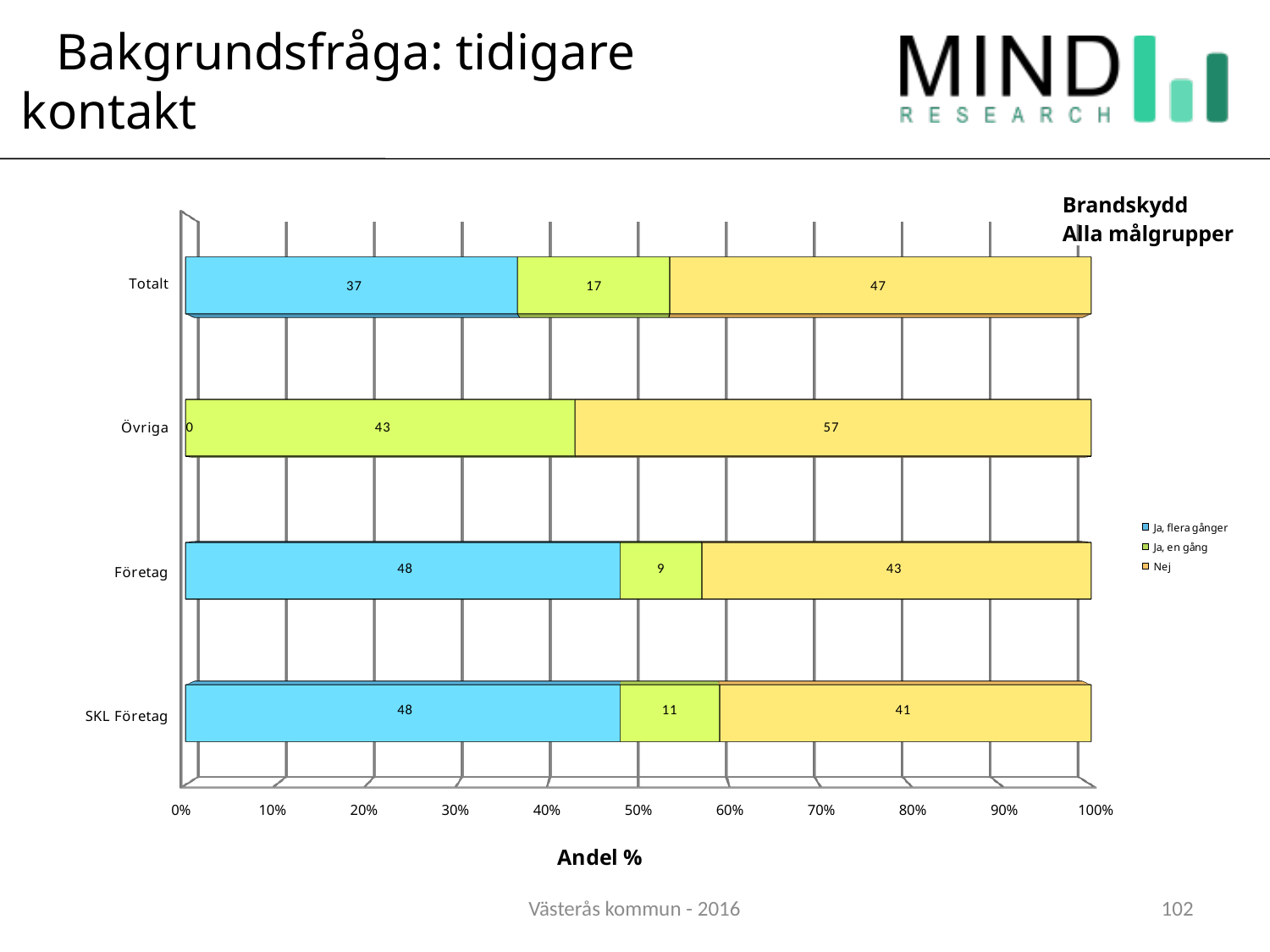
What is the value of "Ja, flera gånger" for SKL Företag? 48 What is the value of "Ja, en gång" for Övriga? 43 Which category has the highest value for "Nej"? Övriga What is the label of the x axis? Andel % What kind of chart is shown on the slide? Stacked bar chart What is the value of "Ja, en gång" for Företag? 9 How many series does the legend list? 3 Which category has the lowest value for "Ja, flera gånger"? Övriga Which is larger: "Ja, en gång" for Totalt or "Ja, en gång" for SKL Företag? Totalt What is the value of "Nej" for Totalt? 47 How many categories are shown on the y axis? 4 What is the difference between the "Nej" values for Övriga and SKL Företag? 16